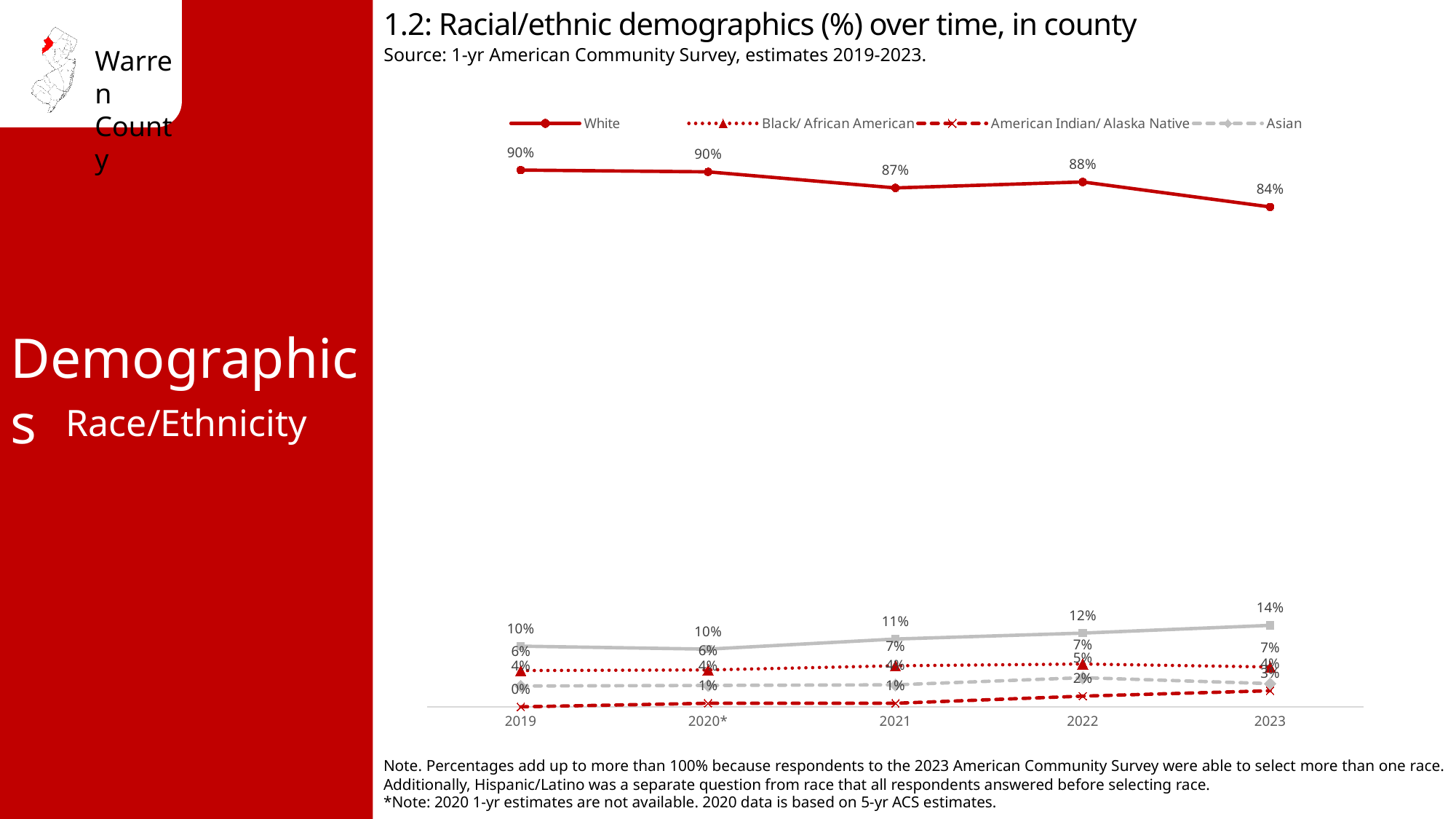
What is the value for White in 2022? 88% What is the value for White in 2023? 84% In which year is the White series at its lowest? 2023 Does the White series generally rise or fall from 2019 to 2023? Fall Which year has the larger White value, 2021 or 2022? 2022 What is the value for White in 2019? 90% What kind of chart is this? Line chart How many series does the legend list? 4 How many years are shown on the x axis? 5 Which series has the highest values across all years? White What is the value for White in 2021? 87% By how many percentage points did the White value change from 2019 to 2023? 6 percentage points